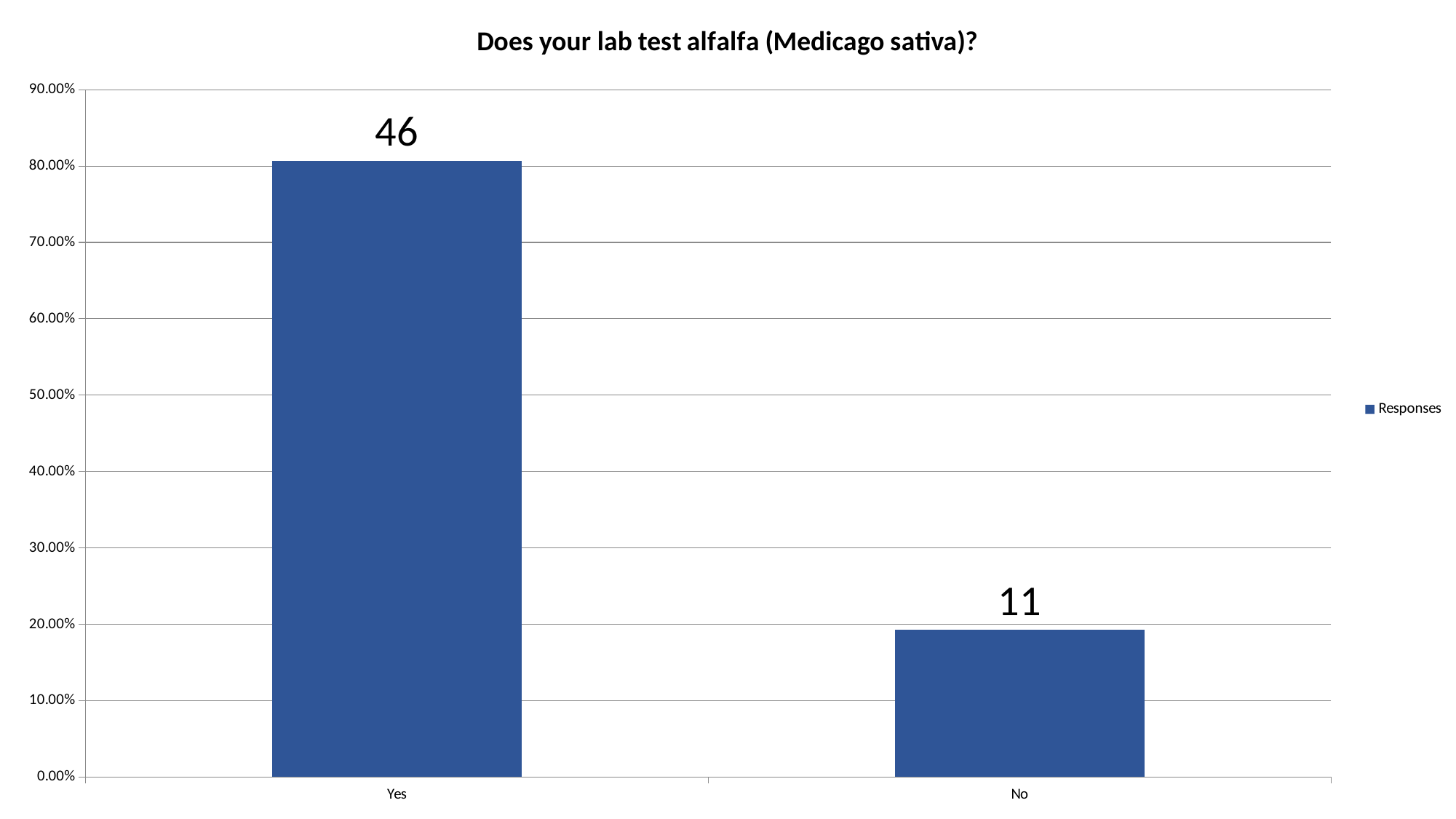
What is the data label shown above the 'No' bar? 11 Which category has the lowest bar? No What is the title of the chart? Does your lab test alfalfa (Medicago sativa)? What is the difference between the data labels for 'Yes' and 'No'? 35 What is the data label shown above the 'Yes' bar? 46 What kind of chart is shown on the slide? Bar chart Which bar is taller, 'Yes' or 'No'? Yes How many categories are shown on the x axis? 2 How many series does the legend list? 1 Which category has the highest bar? Yes